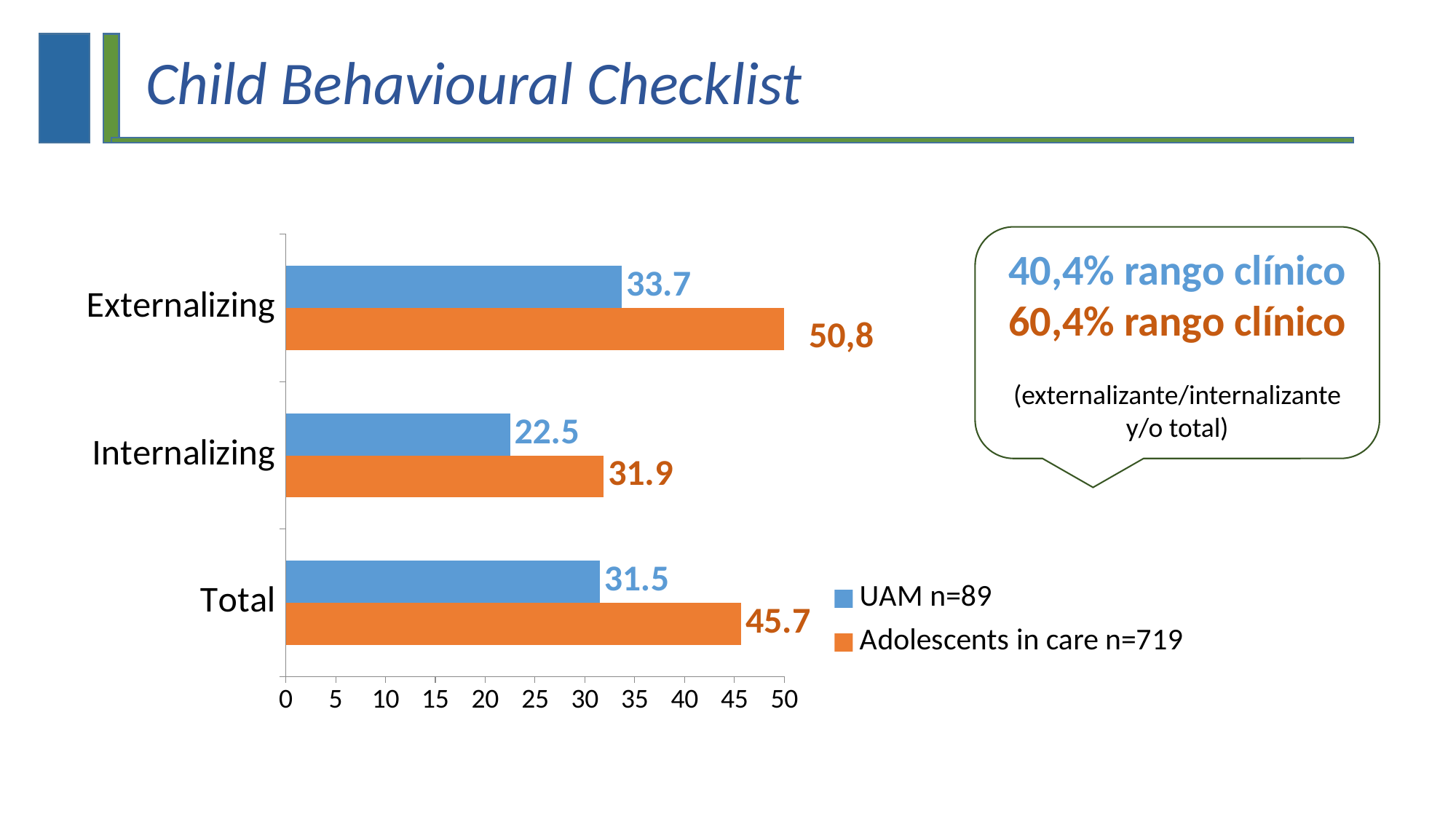
Which is larger in the Total category: UAM n=89 or Adolescents in care n=719? Adolescents in care n=719 What colour are the bars for the UAM n=89 series? blue What is the value for UAM n=89 in the Internalizing category? 22.5 What is the value for Adolescents in care n=719 in the Total category? 45.7 What is the difference between Adolescents in care n=719 and UAM n=89 in the Internalizing category? 9.4 How many categories are shown on the chart? 3 What type of chart is shown on the slide? bar chart Which category has the highest value for Adolescents in care n=719? Externalizing How many series does the legend list? 2 Which category has the lowest value for UAM n=89? Internalizing What is the value for Adolescents in care n=719 in the Externalizing category? 50,8 What is the value for UAM n=89 in the Externalizing category? 33.7